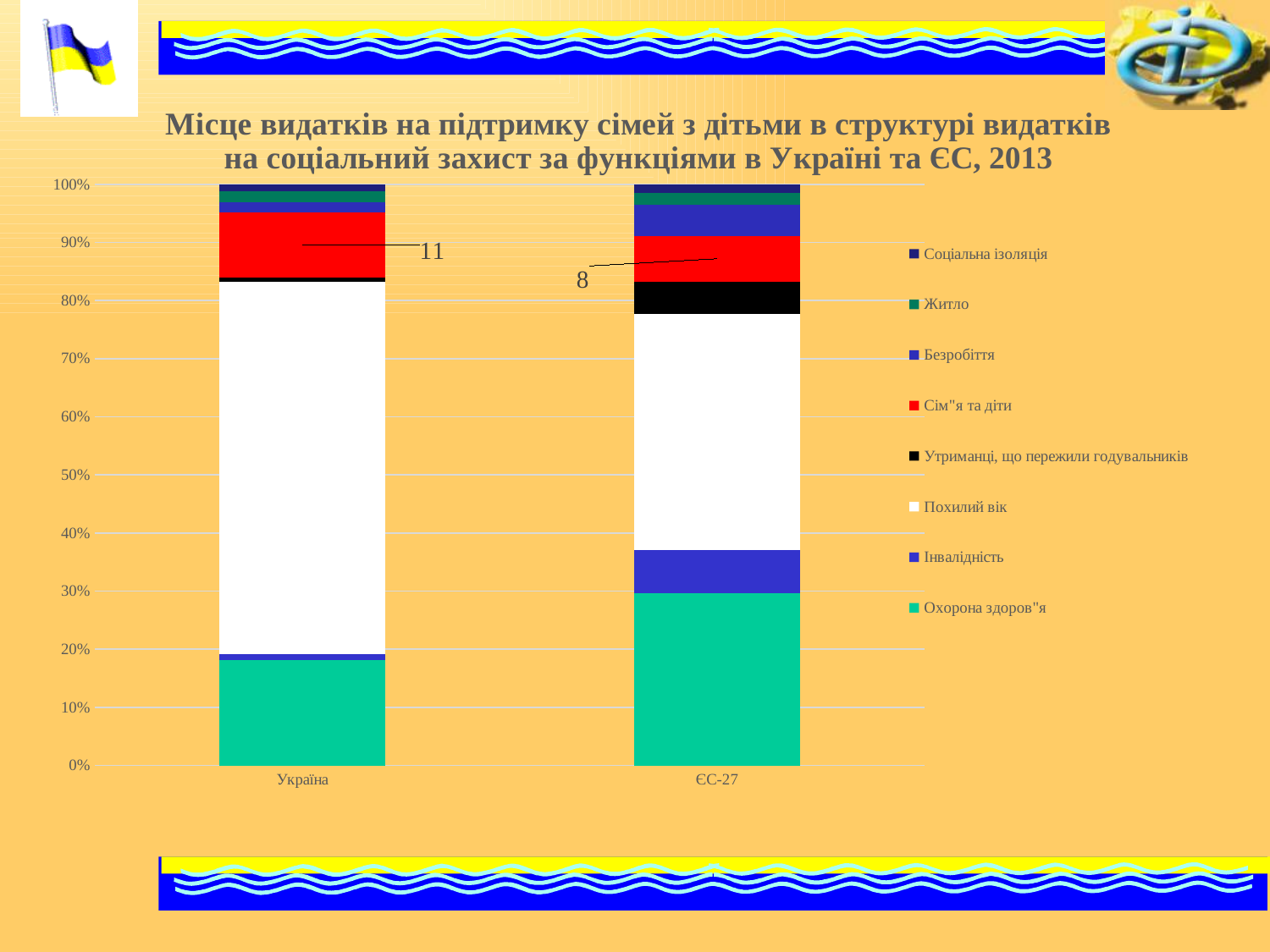
Is the Похилий вік segment in the ЄС-27 bar greater or less than 30%? greater What colour represents Сім"я та діти in the chart? Red Which series is listed first in the legend? Соціальна ізоляція What kind of chart is shown on the slide? Stacked bar chart Is the Охорона здоров"я segment in the Україна bar greater or less than 20%? less What is the difference between the labelled Сім"я та діти values for Україна and ЄС-27? 3 How many series does the legend list? 8 What is the data label shown for Сім"я та діти in the Україна bar? 11 What is the data label shown for Сім"я та діти in the ЄС-27 bar? 8 Which bar has the larger labelled value for Сім"я та діти, Україна or ЄС-27? Україна How many categories are shown on the x axis of the chart? 2 Which bar has the larger Охорона здоров"я segment, Україна or ЄС-27? ЄС-27